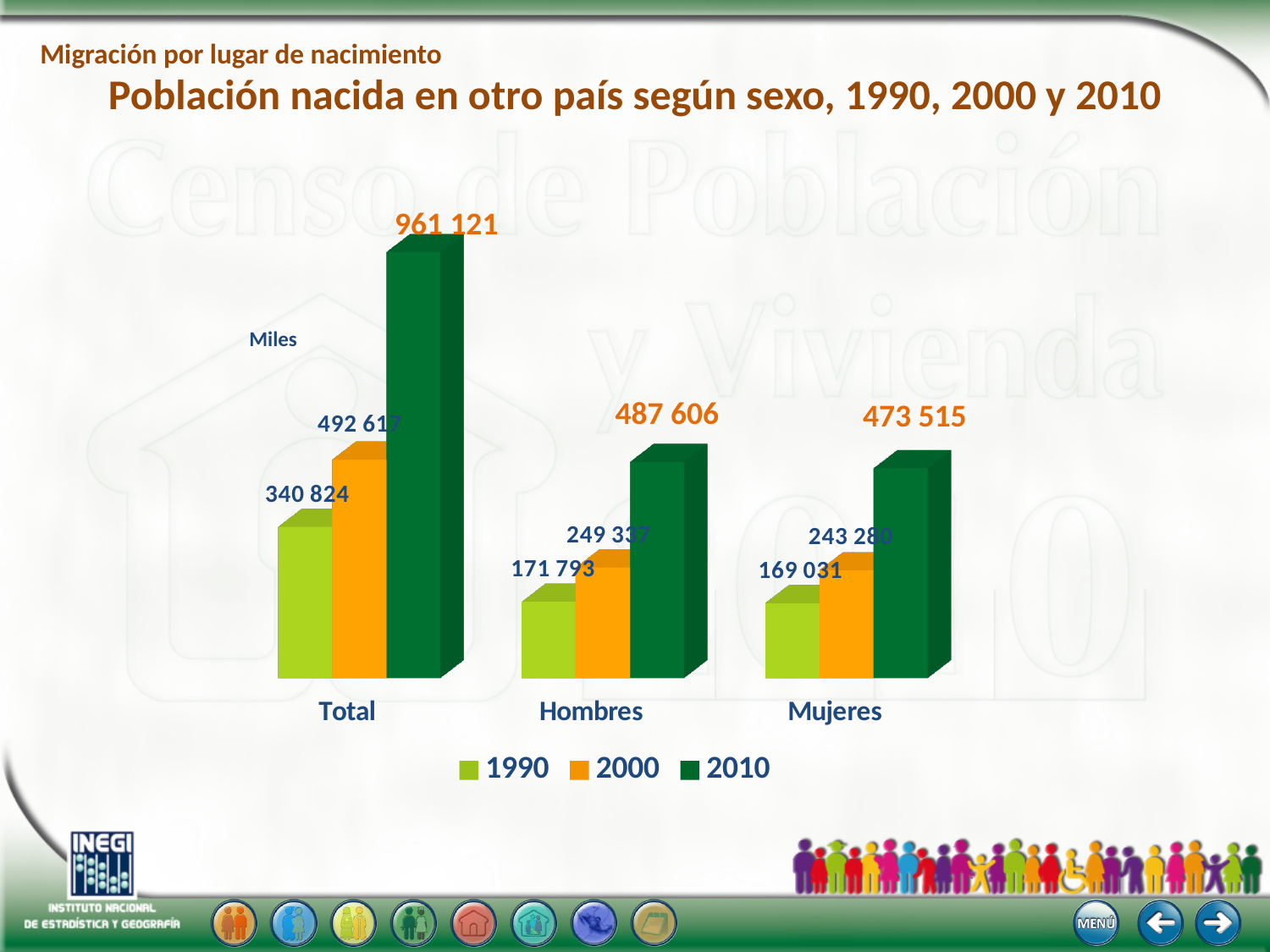
Which category has the highest value in 2010? Total In 2010, which is larger, Hombres or Mujeres? Hombres What is the value for Total in 2010? 961 121 What kind of chart is shown? Bar chart What is the value for Total in 1990? 340 824 What unit label is shown on the chart? Miles How many series does the legend list? 3 What is the value for Hombres in 2010? 487 606 What is the difference between Hombres and Mujeres in 2010? 14 091 By how much did the Total increase from 1990 to 2010? 620 297 What is the value for Hombres in 1990? 171 793 What is the value for Mujeres in 2010? 473 515